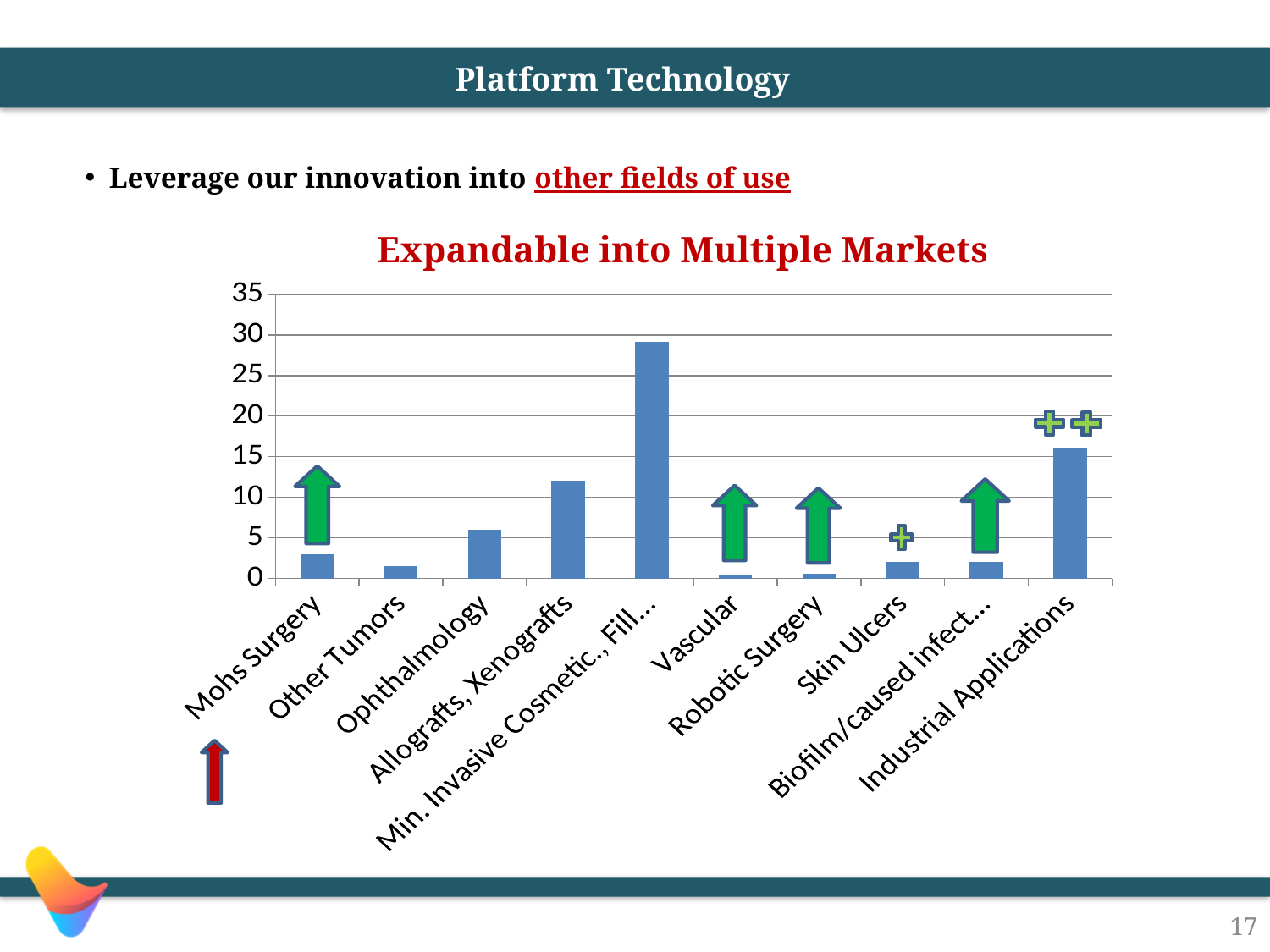
What is the title of the chart? Expandable into Multiple Markets Which category has the highest bar in the chart? Min. Invasive Cosmetic., Fill... What kind of chart is shown on the slide? bar chart Is the value for Industrial Applications greater or less than 20? less Is the value for Mohs Surgery greater or less than 5? less Which is larger, the value for Ophthalmology or the value for Other Tumors? Ophthalmology Is the value for Ophthalmology greater or less than 10? less How many categories are plotted on the x axis of the chart? 10 What is the highest tick value shown on the chart's vertical axis? 35 Which is larger, the value for Industrial Applications or the value for Allografts, Xenografts? Industrial Applications